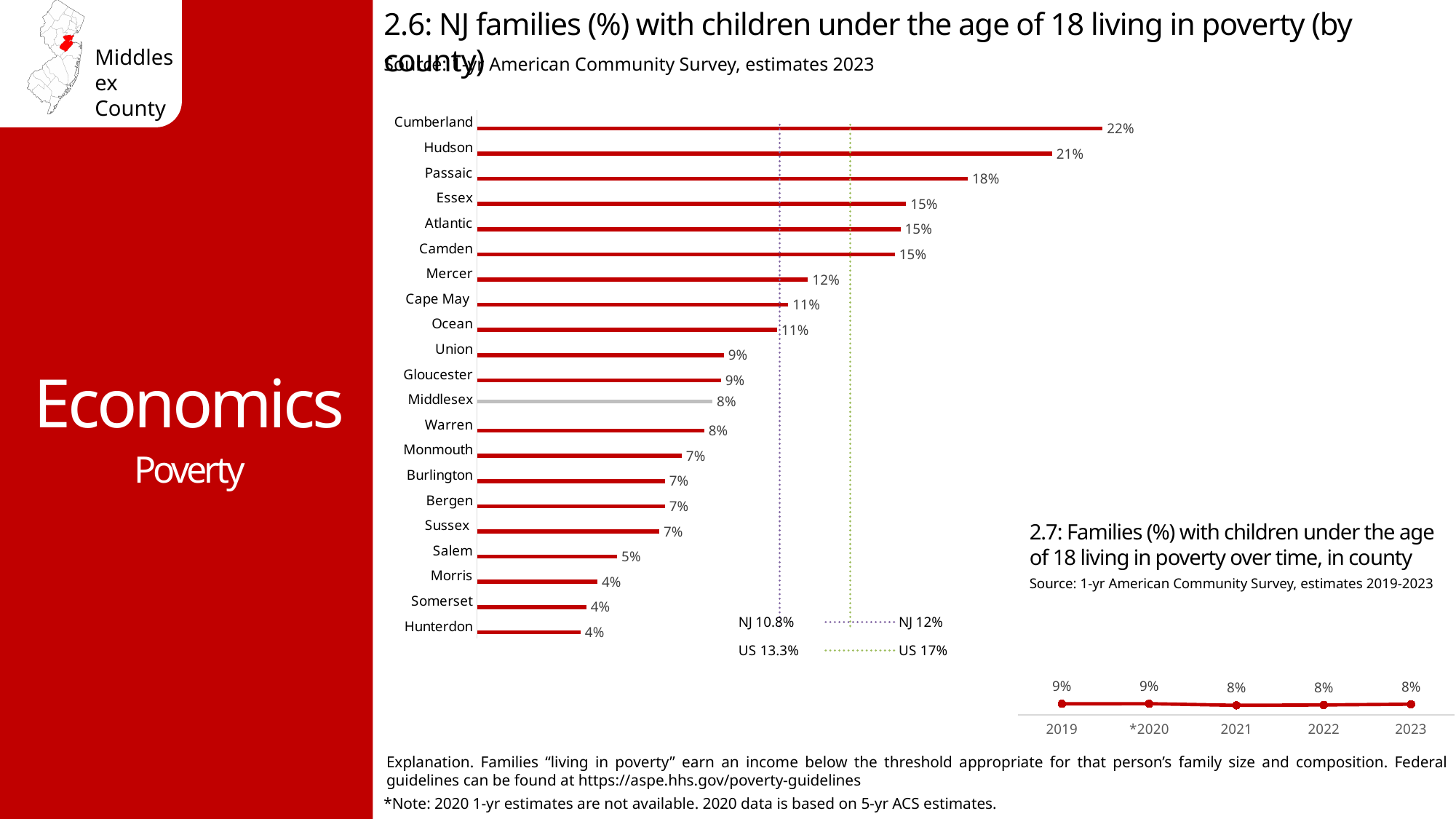
In chart 2.7, what is the value for 2023? 8% In chart 2.6, which is larger, the value for Passaic or the value for Mercer? Passaic In chart 2.7 (families with children under 18 living in poverty over time, in county), what is the value for 2019? 9% In chart 2.7, how many years are plotted? 5 In chart 2.6, what is the difference between the values for Cumberland and Middlesex? 14% What kind of chart is chart 2.6? Bar chart In chart 2.6, how many counties are plotted? 21 In chart 2.6, what is the value for Hudson? 21% In chart 2.6, which county has the highest percentage of families with children living in poverty? Cumberland In chart 2.6, what is the value for Cumberland? 22% In chart 2.6 (NJ families with children under 18 living in poverty by county), what is the value for Middlesex? 8%